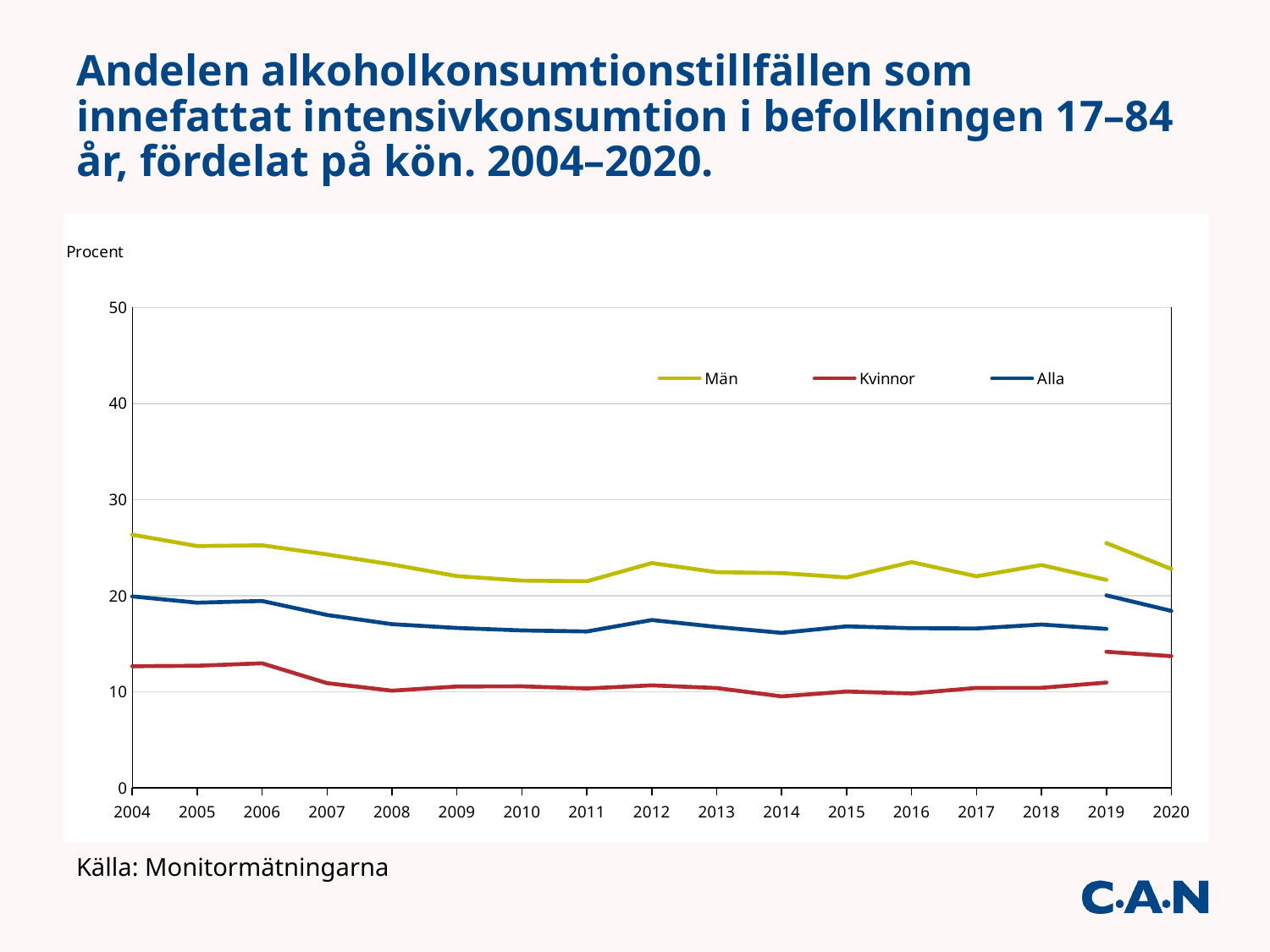
Is the value for Män in 2004 greater or less than 20? greater Which series has the highest value in 2020? Män What kind of chart is shown on the slide? line chart What is the label on the y axis of the chart? Procent Is the value for Män in 2019 greater or less than 20? greater For the Alla series, which year has the larger value, 2004 or 2014? 2004 In 2012, which series has the larger value, Män or Kvinnor? Män Is the value for Alla in 2004 greater or less than 30? less How many series does the legend list? 3 Does the Män series rise or fall from 2004 to 2011? fall How many years are shown along the x axis? 17